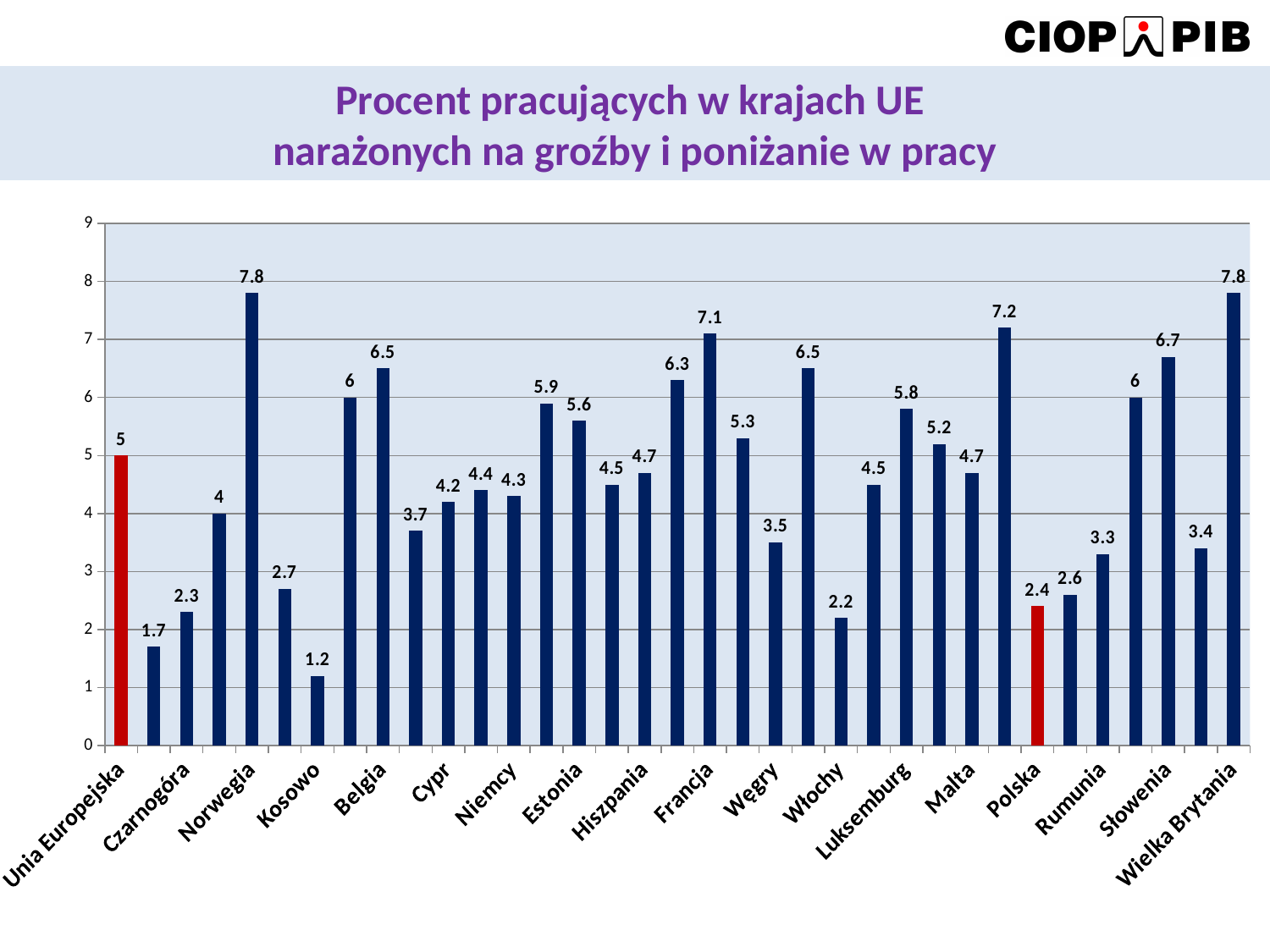
What kind of chart is shown on the slide? Bar chart What is the value for Kosowo? 1.2 Which two bars are coloured red? Unia Europejska and Polska What is the value for Francja? 7.1 What is the value for Unia Europejska? 5 What is the value for Polska? 2.4 Which is larger, the value for Węgry or the value for Rumunia? Węgry What is the difference between the value for Norwegia and the value for Polska? 5.4 Which is larger, the value for Belgia or the value for Słowenia? Słowenia Which labelled country has the lowest value? Kosowo What is the value for Luksemburg? 5.8 What is the difference between the value for Unia Europejska and the value for Polska? 2.6